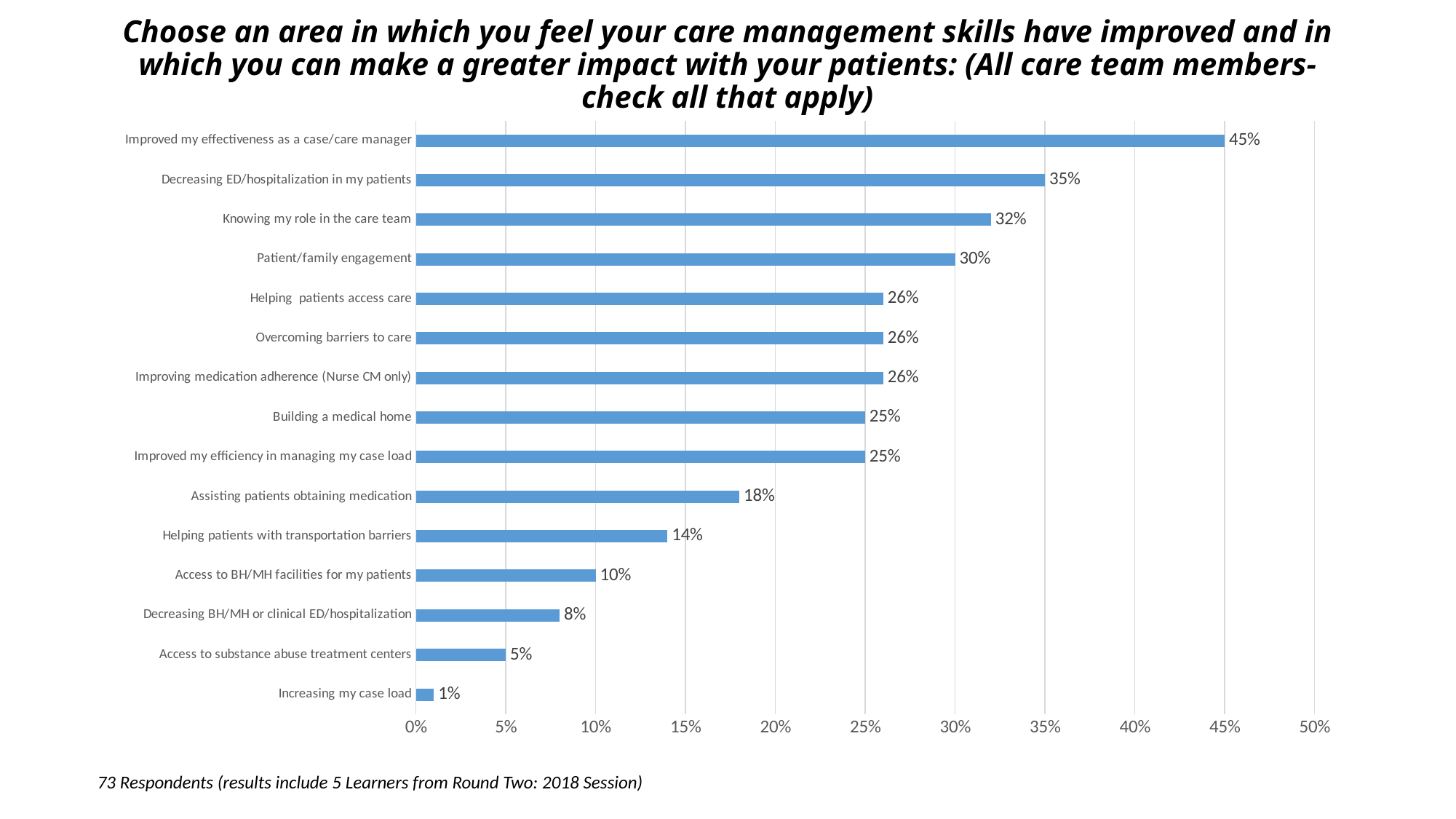
Which is larger: "Assisting patients obtaining medication" or "Access to BH/MH facilities for my patients"? Assisting patients obtaining medication Is the value for "Decreasing BH/MH or clinical ED/hospitalization" greater or less than 10%? less What is the difference between "Improved my effectiveness as a case/care manager" and "Increasing my case load"? 44% What percentage is shown for "Helping patients with transportation barriers"? 14% Which category has the highest value? Improved my effectiveness as a case/care manager What percentage of respondents chose "Improved my effectiveness as a case/care manager"? 45% What is the value for "Knowing my role in the care team"? 32% How many respondents does the note below the chart say took part? 73 Respondents How many categories are shown in the chart? 15 What kind of chart is shown on the slide? Bar chart Which category has the lowest value? Increasing my case load What is the difference between "Decreasing ED/hospitalization in my patients" and "Patient/family engagement"? 5%